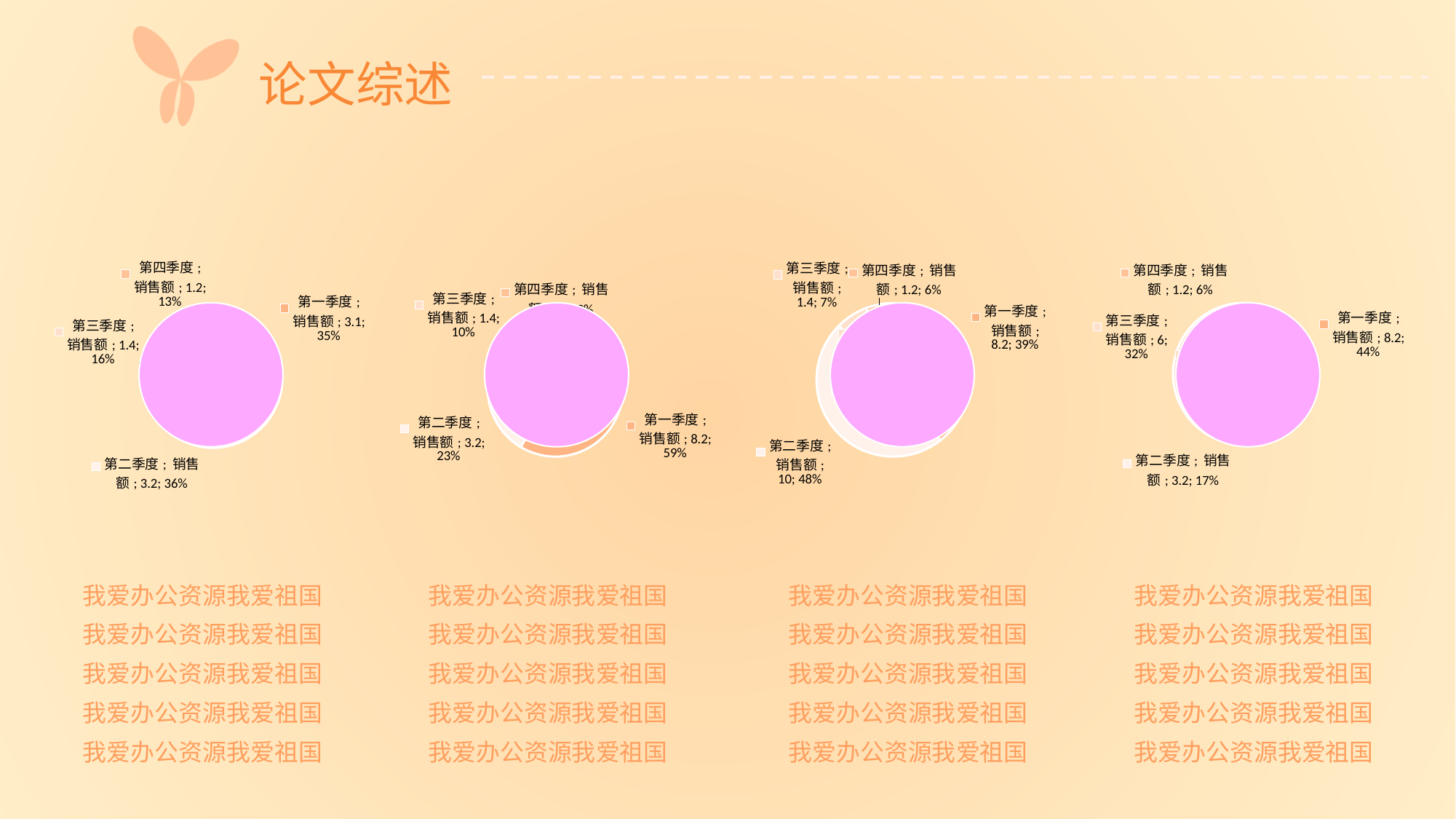
In the leftmost pie chart, which quarter has the smallest share? 第四季度 In the third pie chart from the left, what is the 销售额 value for 第二季度? 10 In the rightmost pie chart, what share of the pie does 第三季度 take? 32% In the leftmost pie chart, what is the 销售额 value for 第二季度? 3.2 In the second pie chart from the left, what share of the pie does 第一季度 take? 59% In the third pie chart from the left, what is the difference between the 销售额 values of 第二季度 and 第一季度? 1.8 What kind of chart is used for each of the four charts on the slide? Pie chart In the third pie chart from the left, which quarter has the largest share? 第二季度 In the leftmost pie chart, what share of the pie does 第四季度 take? 13% How many pie charts are on the slide? 4 In the second pie chart from the left, what is the 销售额 value for 第三季度? 1.4 In the rightmost pie chart, which is larger, the 销售额 for 第二季度 or for 第三季度? 第三季度